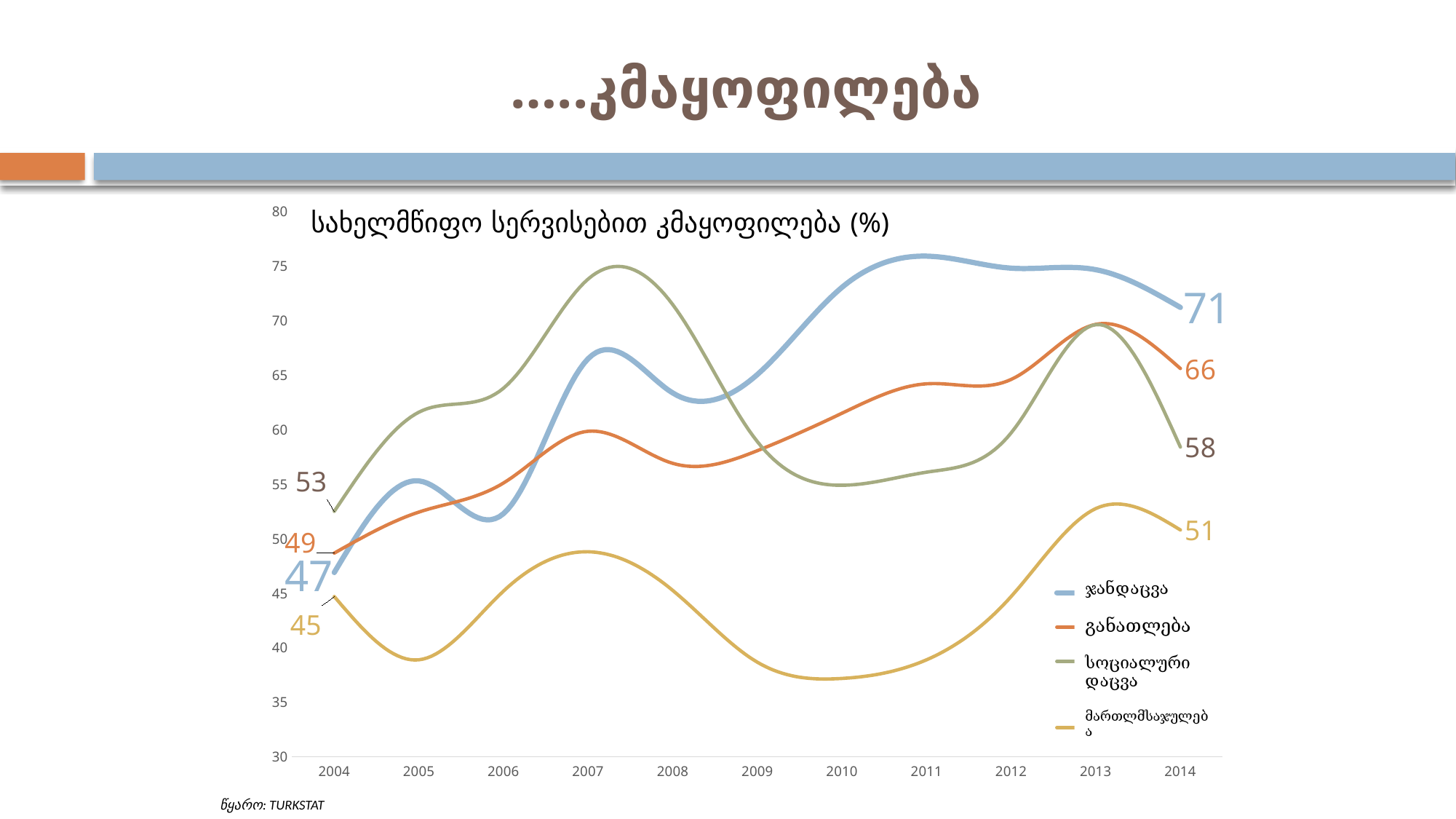
What type of chart is shown on the slide? line chart What is the difference between the ჯანდაცვა values in 2014 and 2004? 24 How many series does the legend list? 4 Is the value for მართლმსაჯულება in 2010 greater or less than 40? less Which series has the lowest value in 2004? მართლმსაჯულება What is the value for ჯანდაცვა in 2014? 71 Which series has the highest value in 2014? ჯანდაცვა What is the value for მართლმსაჯულება in 2004? 45 In 2014, which is larger: the value for განათლება or the value for სოციალური დაცვა? განათლება What is the value for განათლება in 2004? 49 How many years are shown on the x axis? 11 What is the value for სოციალური დაცვა in 2014? 58